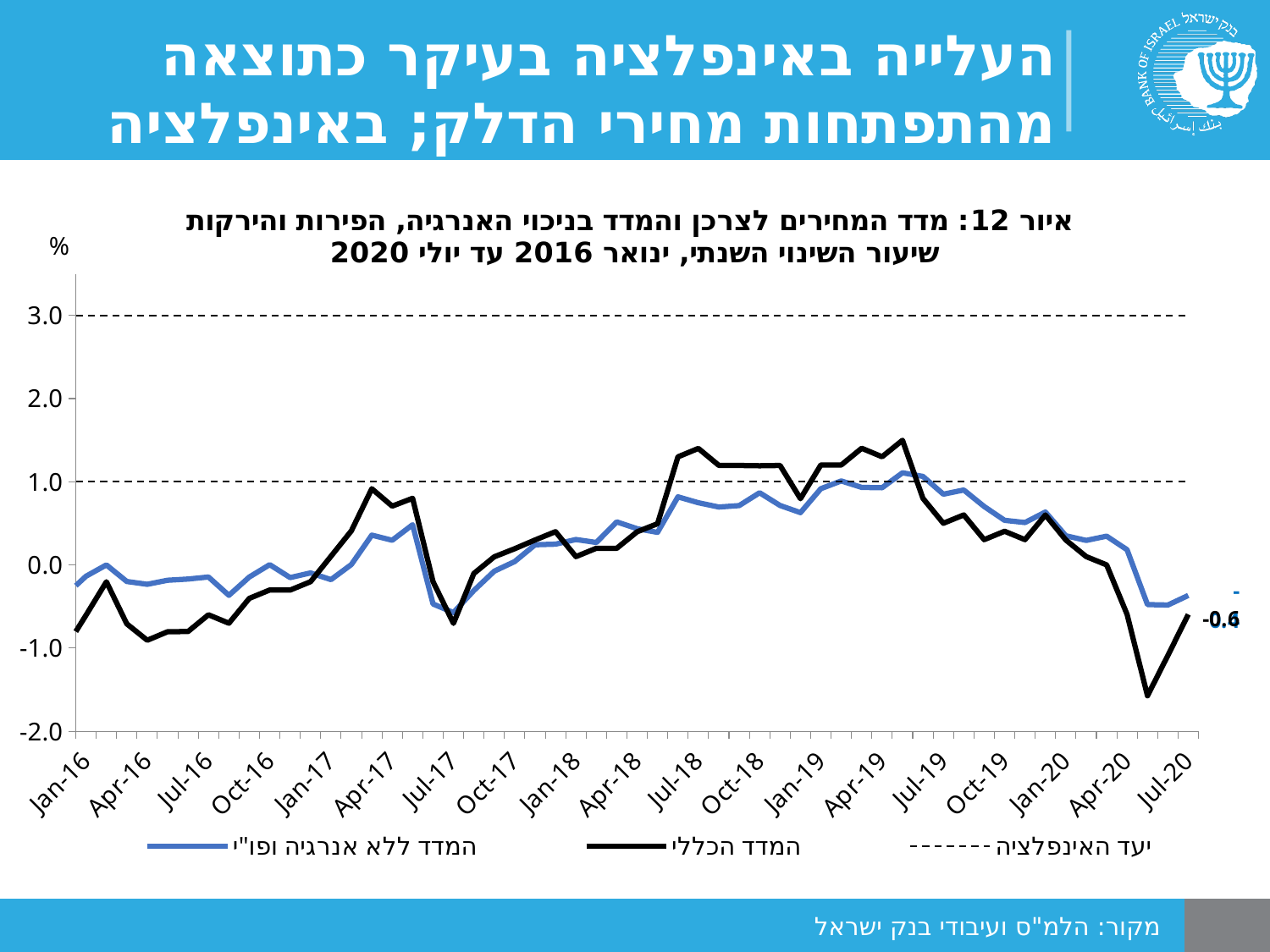
At Jan-16, which series is higher: המדד הכללי or המדד ללא אנרגיה ופו"י? המדד ללא אנרגיה ופו"י Is the value of המדד הכללי at Jul-18 greater or less than 1.0? greater What unit is shown at the top of the y axis? % What is the value of המדד הכללי (the general index) at Jul-20, as printed on the chart? -0.6 At which two levels are the dashed יעד האינפלציה (inflation target) lines drawn? 1.0 and 3.0 Does המדד הכללי rise or fall between Jan-20 and Apr-20? fall Is the value of המדד הכללי at Apr-17 greater or less than 0.0? greater How many entries does the legend list? 3 What kind of chart is shown on the slide? line chart Is the value of המדד הכללי at Jan-16 greater or less than 0.0? less At Jul-18, which series is higher: המדד הכללי or המדד ללא אנרגיה ופו"י? המדד הכללי